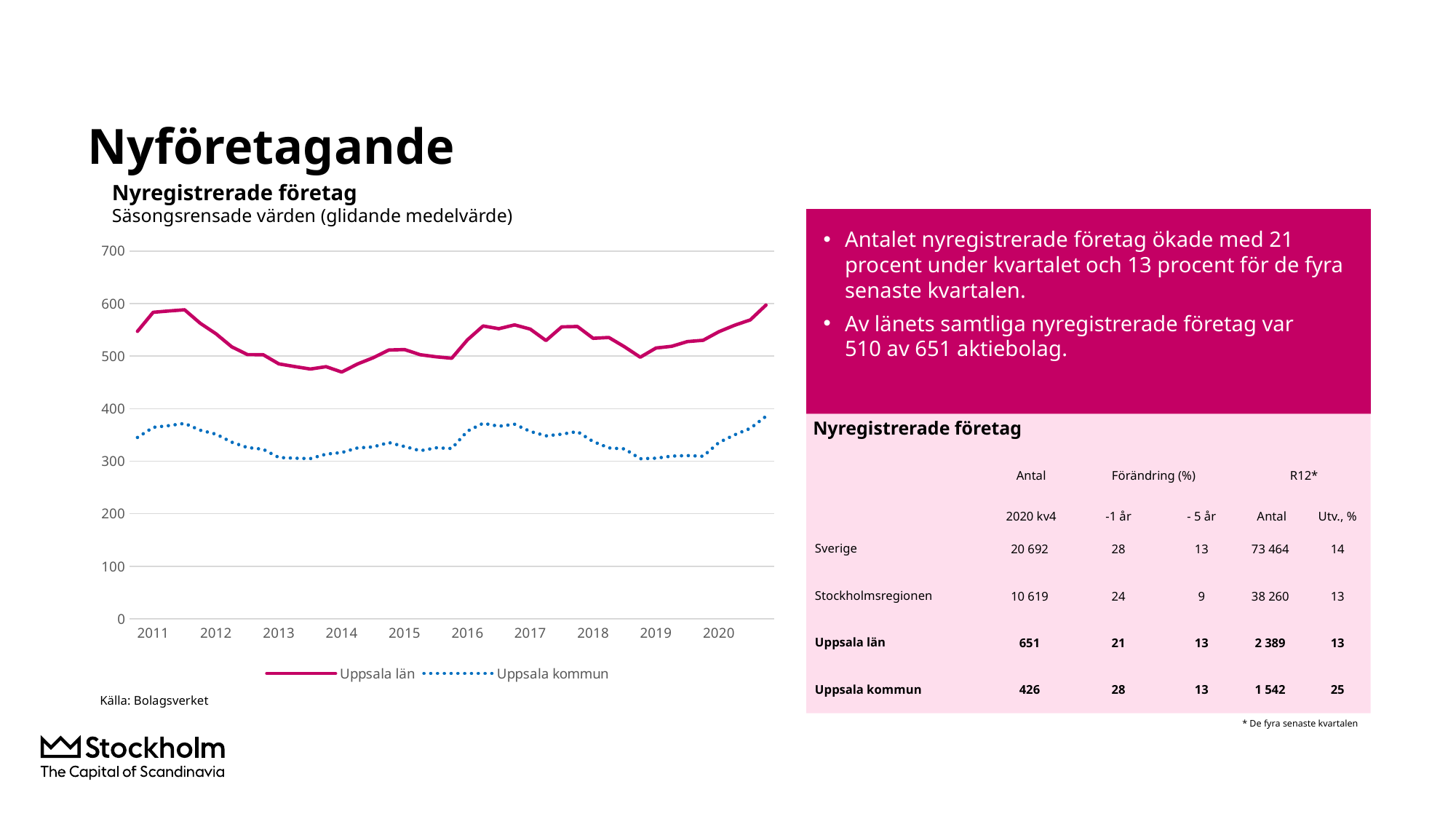
What is the title of the chart? Nyregistrerade företag Does the Uppsala län line rise or fall between 2011 and 2014? fall Is the value for Uppsala kommun at 2011 greater or less than 300? greater Is the value for Uppsala kommun at 2016 greater or less than 400? less Does the Uppsala kommun line rise or fall between 2019 and the end of 2020? rise Is the value for Uppsala län at 2014 greater or less than 500? less Which series has the higher values throughout the chart, Uppsala län or Uppsala kommun? Uppsala län What kind of chart is shown on the slide? line chart How many series does the chart legend list? 2 How many year labels are shown on the x axis of the chart? 10 What are the two series named in the chart legend? Uppsala län and Uppsala kommun